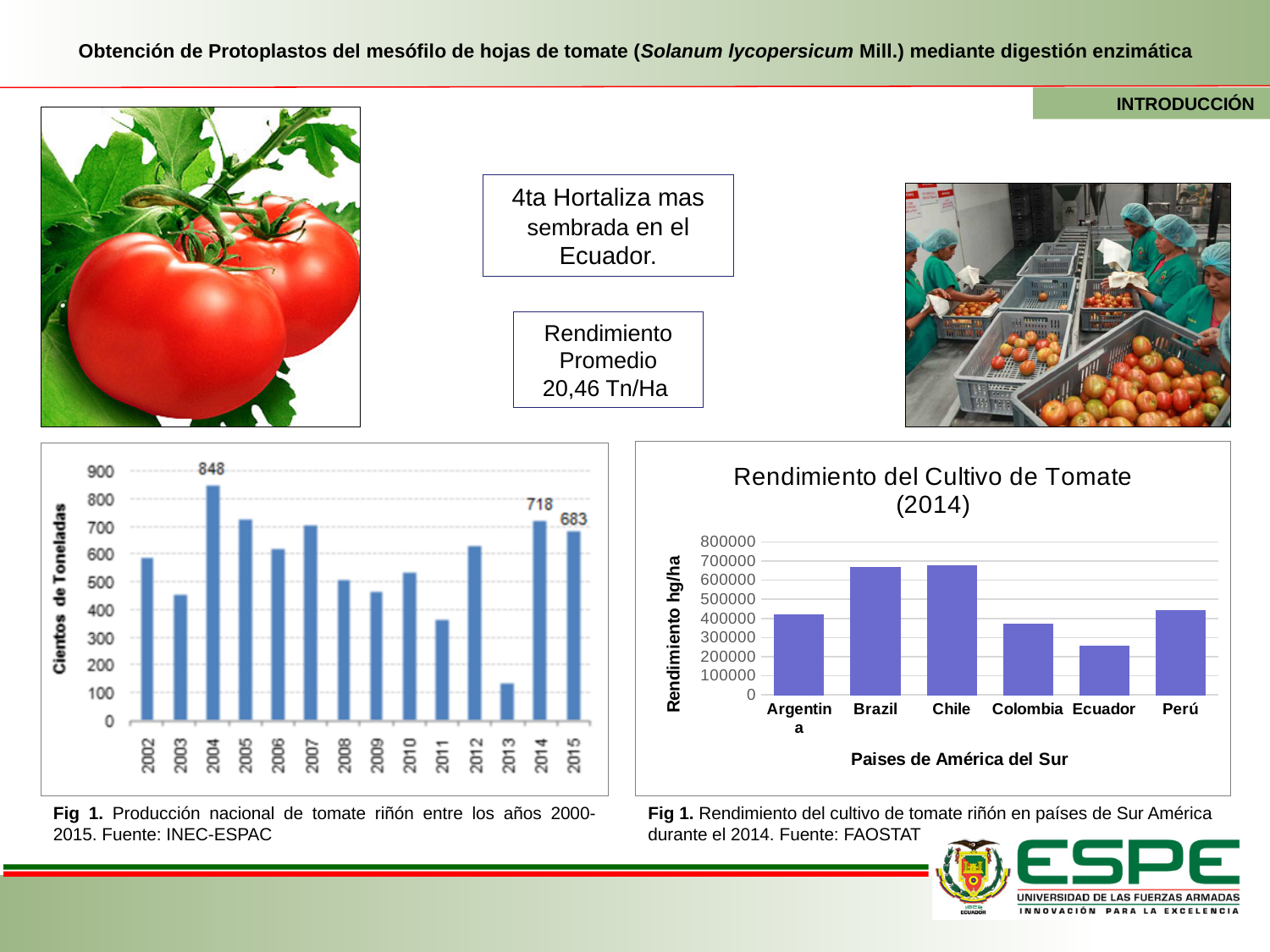
In the left chart (Producción nacional de tomate riñón), which year has the lowest value? 2013 In the left chart (Producción nacional de tomate riñón), what is the value for 2015? 683 In the left chart (Producción nacional de tomate riñón), is the value for 2013 greater or less than 200? less What kind of chart is the right chart (Rendimiento del Cultivo de Tomate 2014)? bar chart In the left chart (Producción nacional de tomate riñón), what is the difference between the values for 2014 and 2015? 35 In the right chart (Rendimiento del Cultivo de Tomate 2014), is the value for Ecuador greater or less than 300000? less In the left chart (Producción nacional de tomate riñón), which year has the highest value? 2004 In the right chart (Rendimiento del Cultivo de Tomate 2014), how many countries are shown? 6 In the right chart (Rendimiento del Cultivo de Tomate 2014), which is larger, the value for Perú or the value for Colombia? Perú In the left chart (Producción nacional de tomate riñón), how many years are shown on the x axis? 14 In the right chart (Rendimiento del Cultivo de Tomate 2014), which country has the lowest yield? Ecuador In the left chart (Producción nacional de tomate riñón), what is the value for 2004? 848